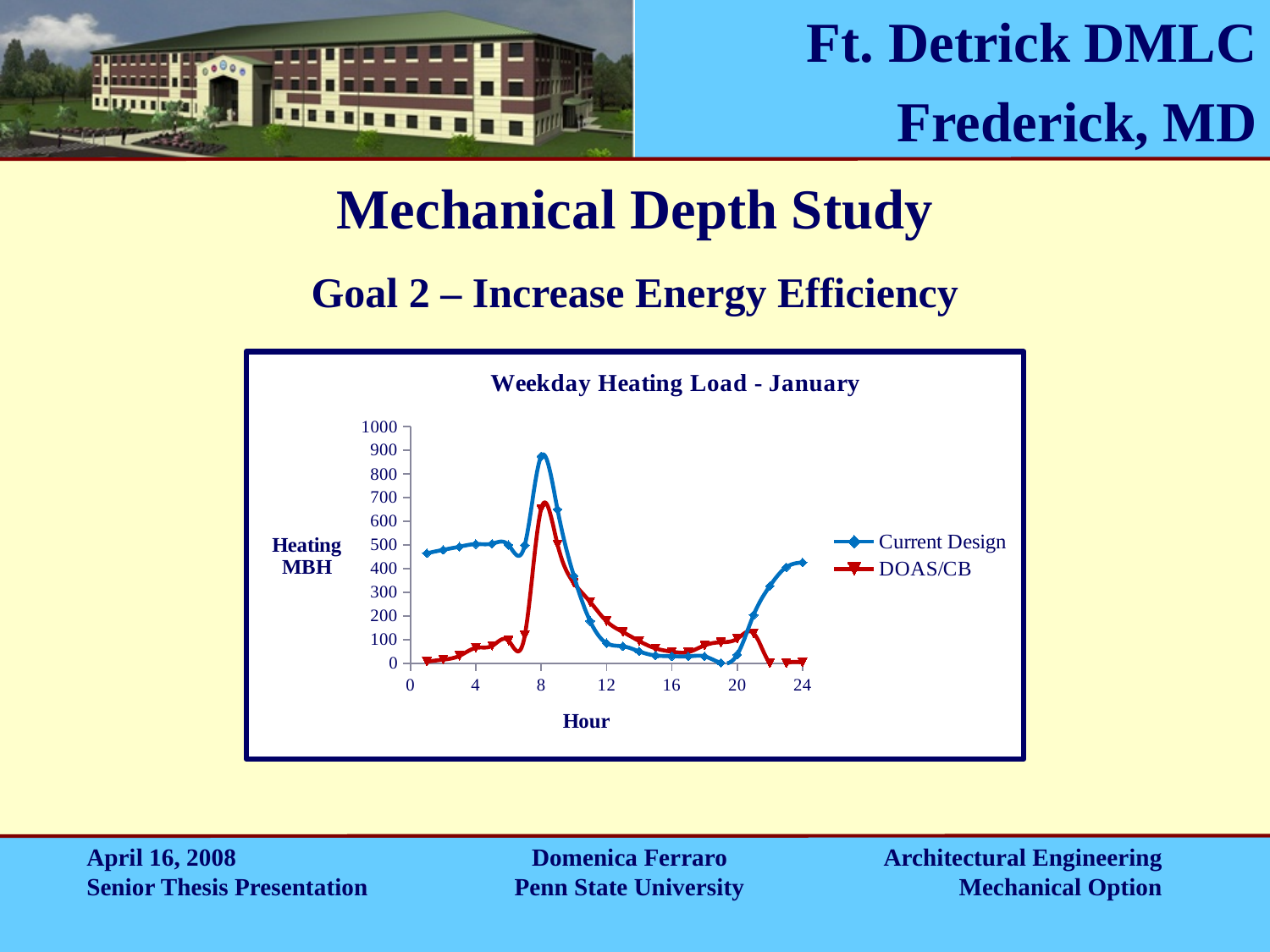
Is the DOAS/CB value at hour 8 greater or less than 500? greater How many series does the legend list? 2 Is the DOAS/CB value at hour 1 greater or less than 100? less Which series is drawn in blue? Current Design Is the Current Design value at hour 8 greater or less than 800? greater What is the title of the chart? Weekday Heating Load - January At hour 8, which series has the higher heating load, Current Design or DOAS/CB? Current Design At hour 24, which series has the higher heating load, Current Design or DOAS/CB? Current Design At which hour does the Current Design series reach its highest value? 8 What kind of chart is shown on the slide? line chart Does the Current Design line rise or fall between hour 20 and hour 24? rise